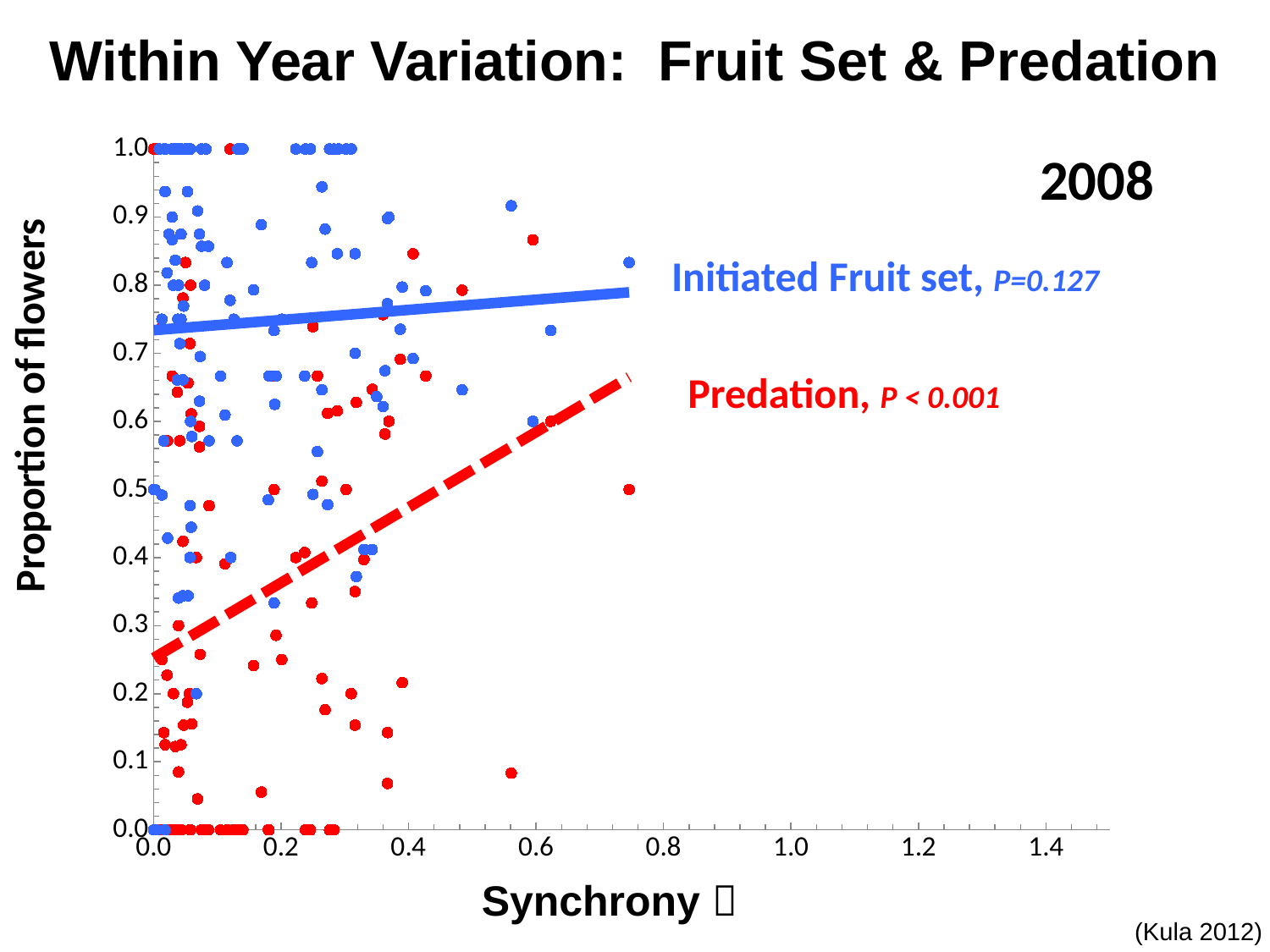
Does the Initiated Fruit set trend line rise or fall as Synchrony increases? rises How many data series are plotted on the chart? 2 What P value is given for Predation? P < 0.001 What is the label of the y axis? Proportion of flowers What P value is given for Initiated Fruit set? P=0.127 What kind of chart is shown on the slide? scatter plot Which year does the chart show data for? 2008 Is the Initiated Fruit set trend line at Synchrony 0.0 greater or less than 0.7? greater What is the title of the chart on the slide? Within Year Variation: Fruit Set & Predation Does the Predation trend line rise or fall as Synchrony increases? rises Which series has the steeper trend line, Initiated Fruit set or Predation? Predation Is the Predation trend line at Synchrony 0.0 greater or less than 0.4? less